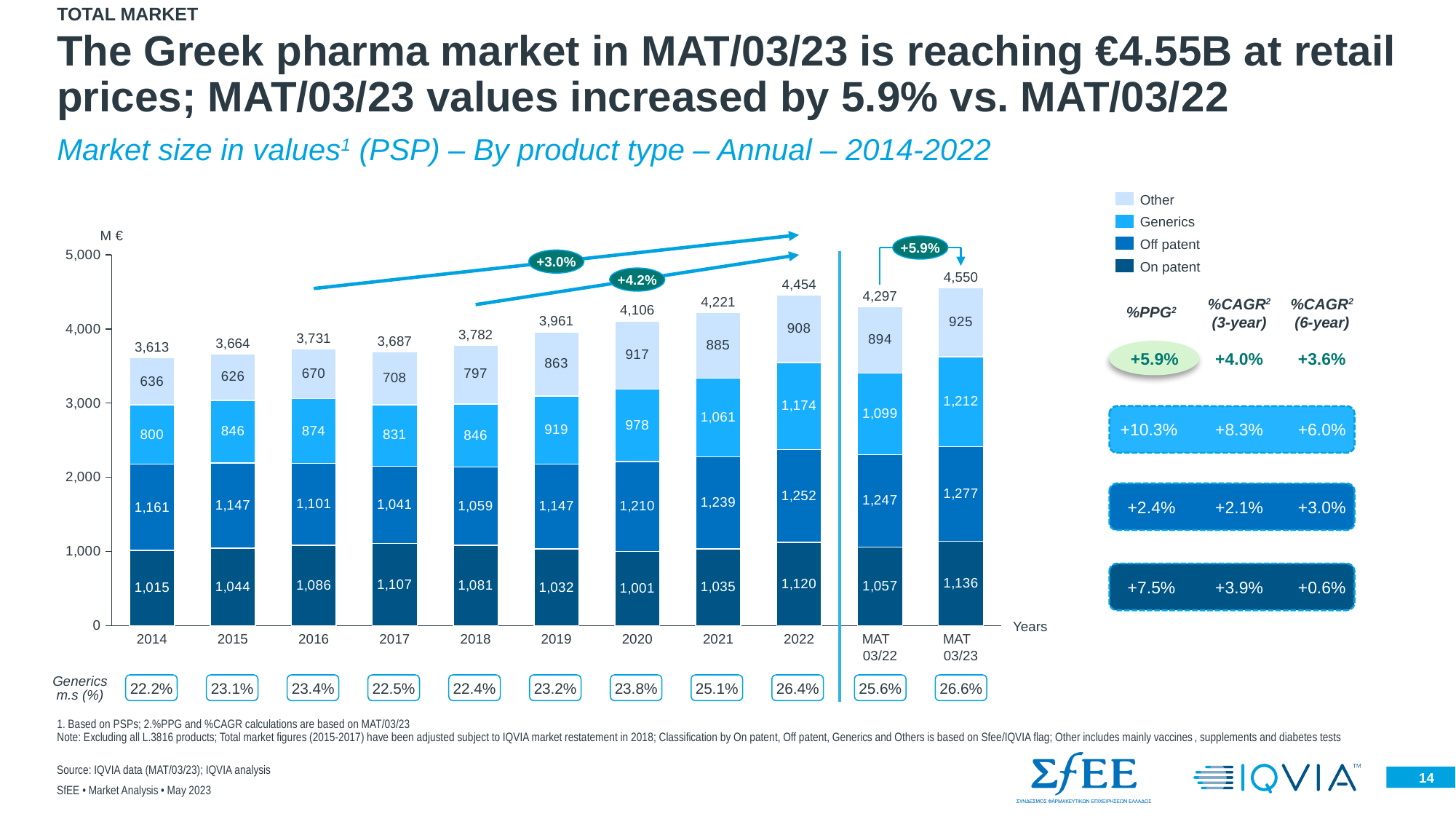
What kind of chart is shown on the slide? Stacked bar chart What is the Other value for 2019? 863 What is the Generics market share (m.s.) shown for 2022? 26.4% How many series does the legend list? 4 Which year has the lowest total market value? 2014 In 2022, which is larger: the Generics value or the Off patent value? Off patent Which period has the highest total market value? MAT 03/23 What is the total market value for MAT 03/23? 4,550 What is the difference between the total market value in 2022 and in 2021? 233 What is the On patent value for 2016? 1,086 How many bars are plotted in the chart (including the MAT periods)? 11 What is the Generics value for 2020? 978